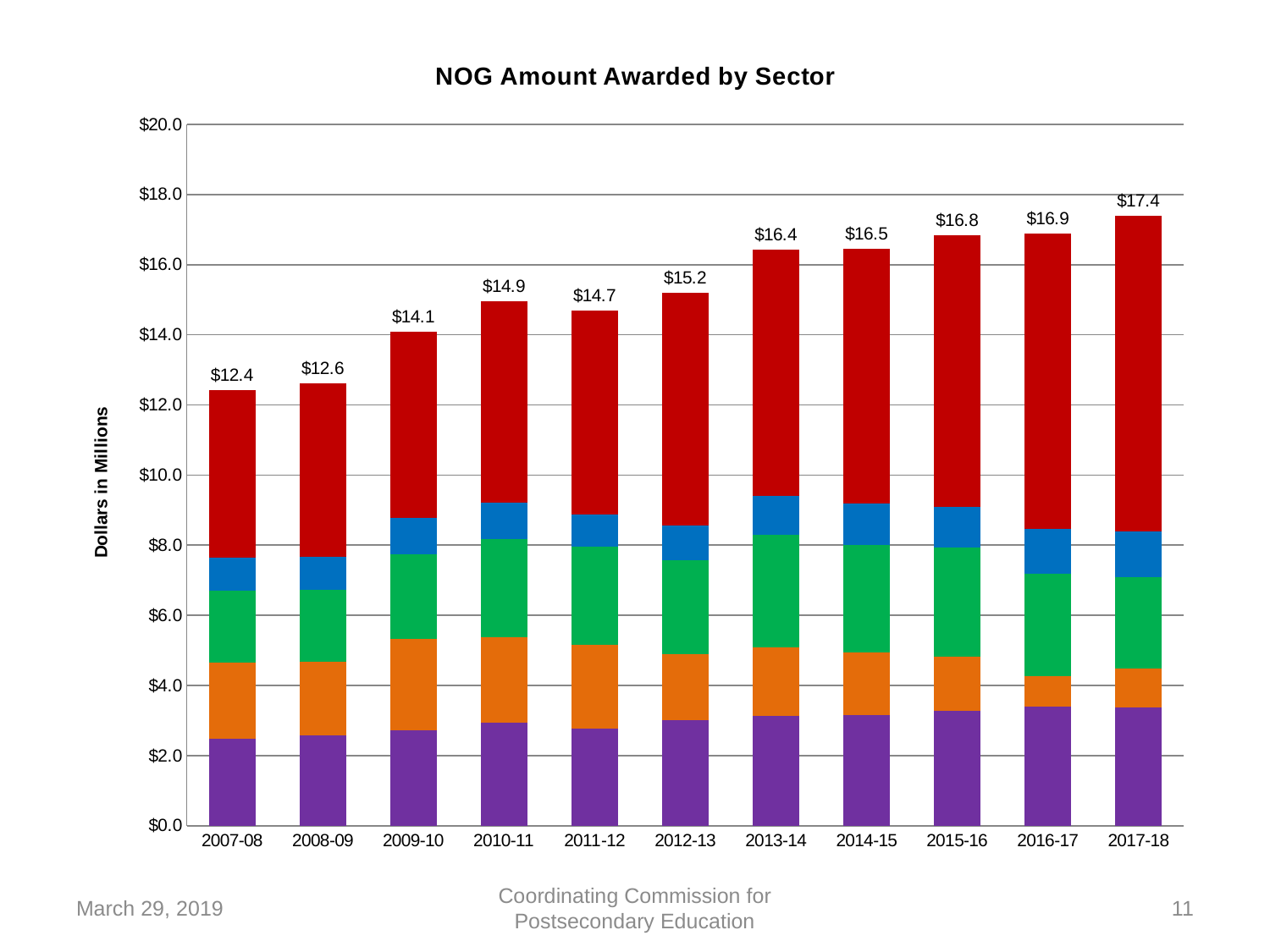
What kind of chart is shown on the slide? Stacked bar chart How many years are shown on the x axis of the chart? 11 What is the label on the vertical axis of the chart? Dollars in Millions What is the difference between the total NOG amount awarded in 2017-18 and in 2007-08? $5.0 Which year has the highest total NOG amount awarded? 2017-18 What is the total NOG amount awarded in 2007-08? $12.4 What is the total NOG amount awarded in 2017-18? $17.4 What is the total NOG amount awarded in 2012-13? $15.2 Which year has the lowest total NOG amount awarded? 2007-08 Is the total NOG amount awarded in 2013-14 greater or less than $16.0? greater Which year has a larger total NOG amount awarded, 2010-11 or 2011-12? 2010-11 Do the total NOG amounts awarded generally rise or fall from 2007-08 to 2017-18? Rise